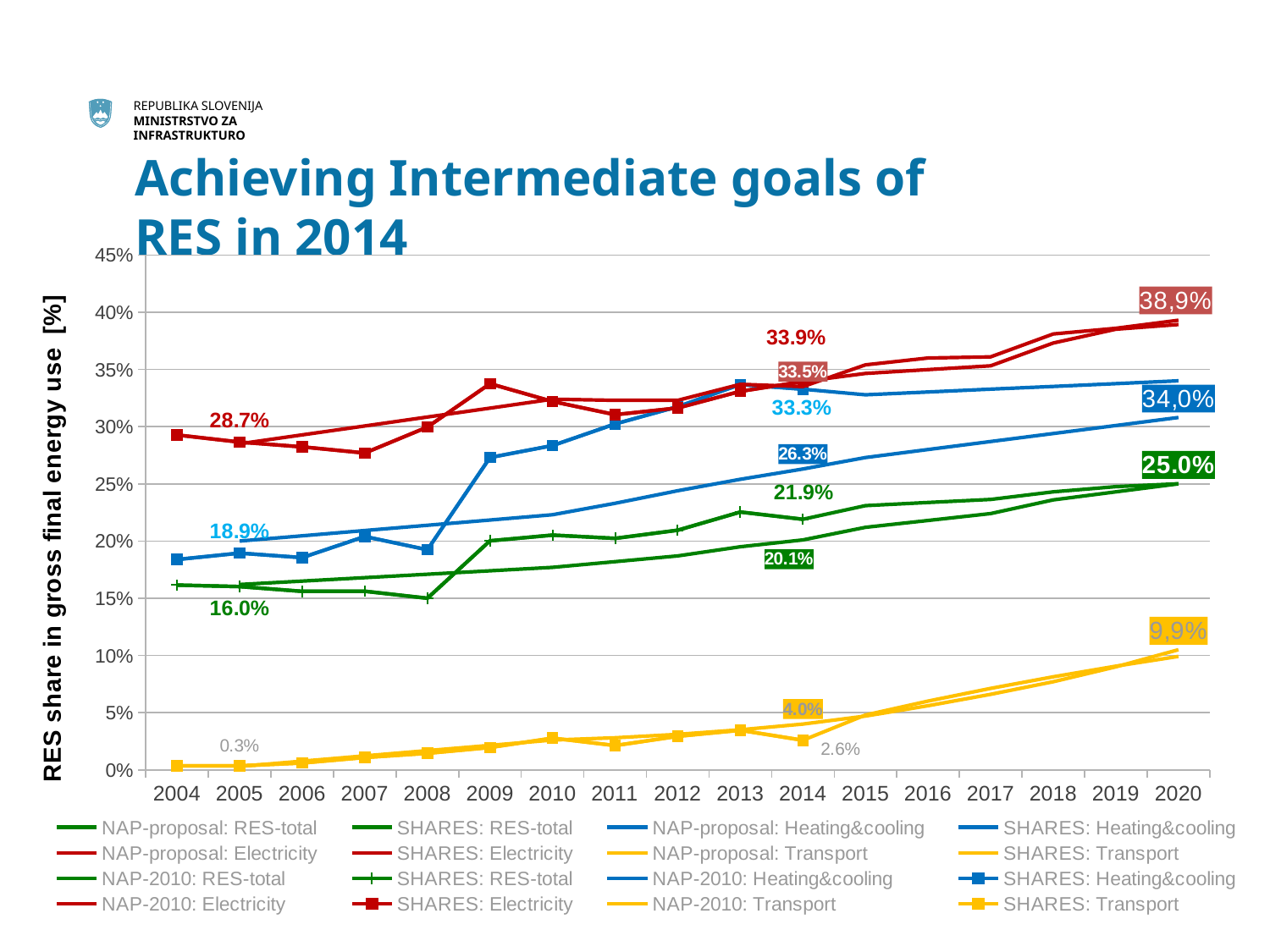
What value is labelled for 2020 on the green RES-total line? 25.0% What value is labelled for the green RES-total line in 2005? 16.0% How many series does the legend list? 16 What value is labelled for 2020 on the red Electricity line? 38,9% What value is labelled for 2020 on the yellow Transport line? 9,9% What value is labelled for 2020 on the blue Heating&cooling line? 34,0% Which sector has the lowest labelled value in 2020? Transport Which sector has the highest labelled value in 2020? Electricity What kind of chart is shown on the slide? line chart What is the difference between the 2020 labels for Electricity (38,9%) and Heating&cooling (34,0%)? 4.9 percentage points How many years are shown along the x axis? 17 Is the Transport value in 2010 greater or less than 5%? less